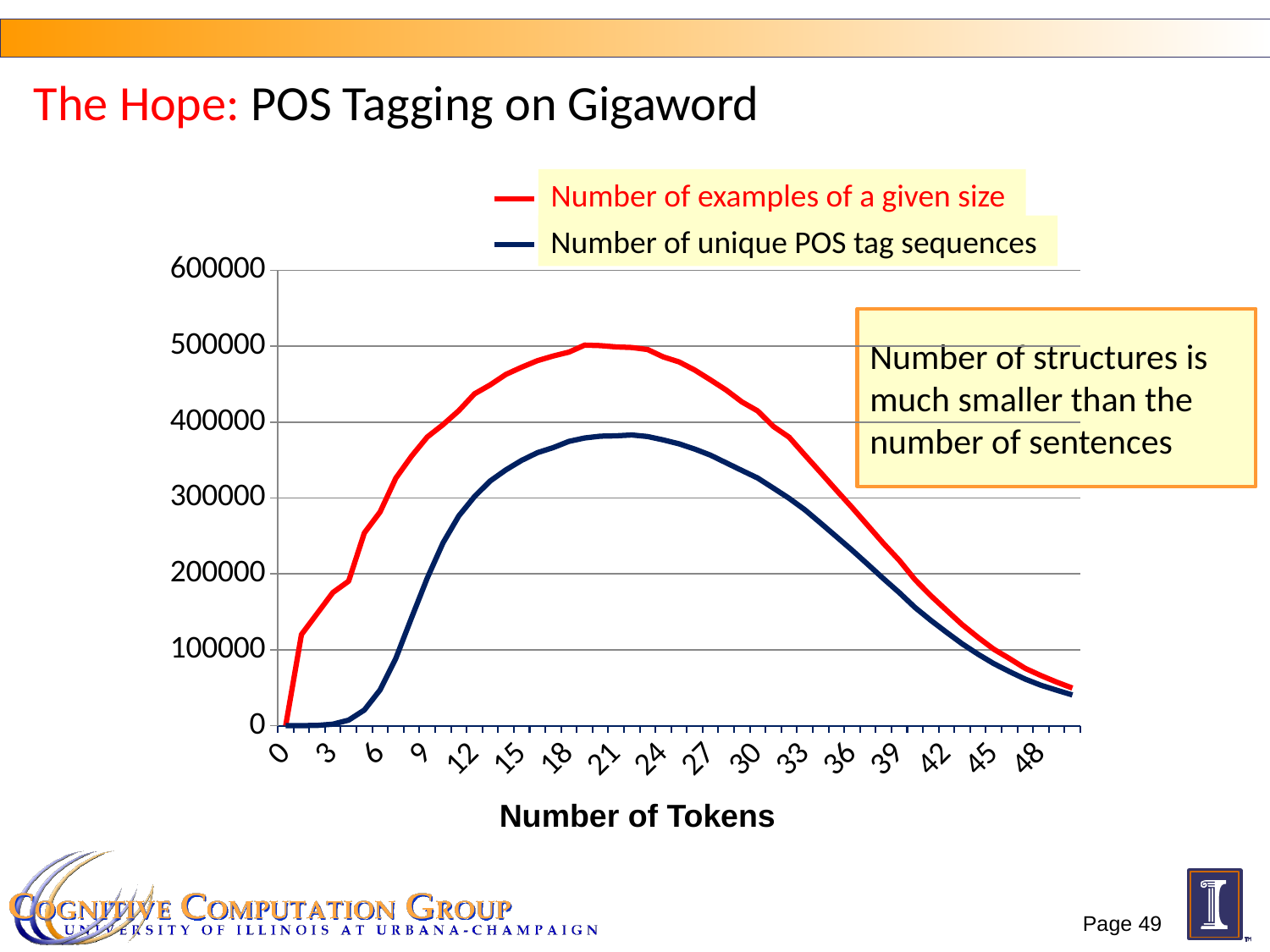
Is the value of 'Number of unique POS tag sequences' at 39 tokens greater or less than 200000? less Is the value of 'Number of examples of a given size' at 12 tokens greater or less than 400000? greater At 12 tokens, which series has the larger value: 'Number of examples of a given size' or 'Number of unique POS tag sequences'? Number of examples of a given size How many series does the legend list? 2 What is the title of the x axis? Number of Tokens Between 24 and 48 tokens, does the 'Number of examples of a given size' line rise or fall? fall Is the value of 'Number of examples of a given size' at 48 tokens greater or less than 100000? less Which series reaches the higher peak value? Number of examples of a given size Which series is drawn in red? Number of examples of a given size What kind of chart is shown on the slide? line chart